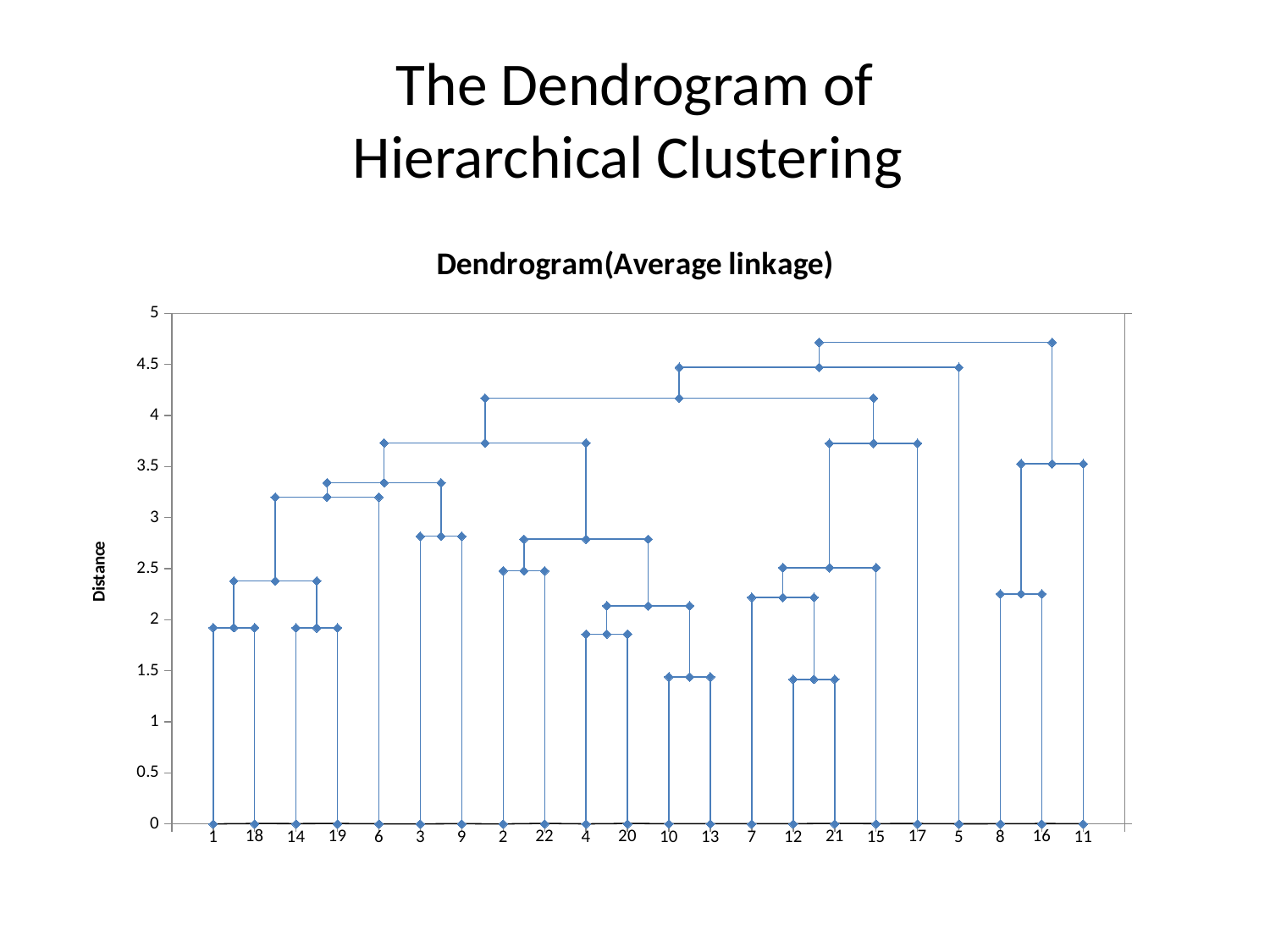
Is the distance at which observations 3 and 9 are merged greater or less than 2.5? greater Is the distance at which observations 8 and 16 are merged greater or less than 2? greater What kind of diagram is shown on the slide? Dendrogram Is the distance of the topmost (final) merge in the dendrogram greater or less than 4.5? greater What is the maximum value shown on the Distance axis? 5 What is the label on the vertical axis of the chart? Distance What is the title of the chart? Dendrogram(Average linkage) How many leaf labels (observations) are shown along the x axis of the dendrogram? 22